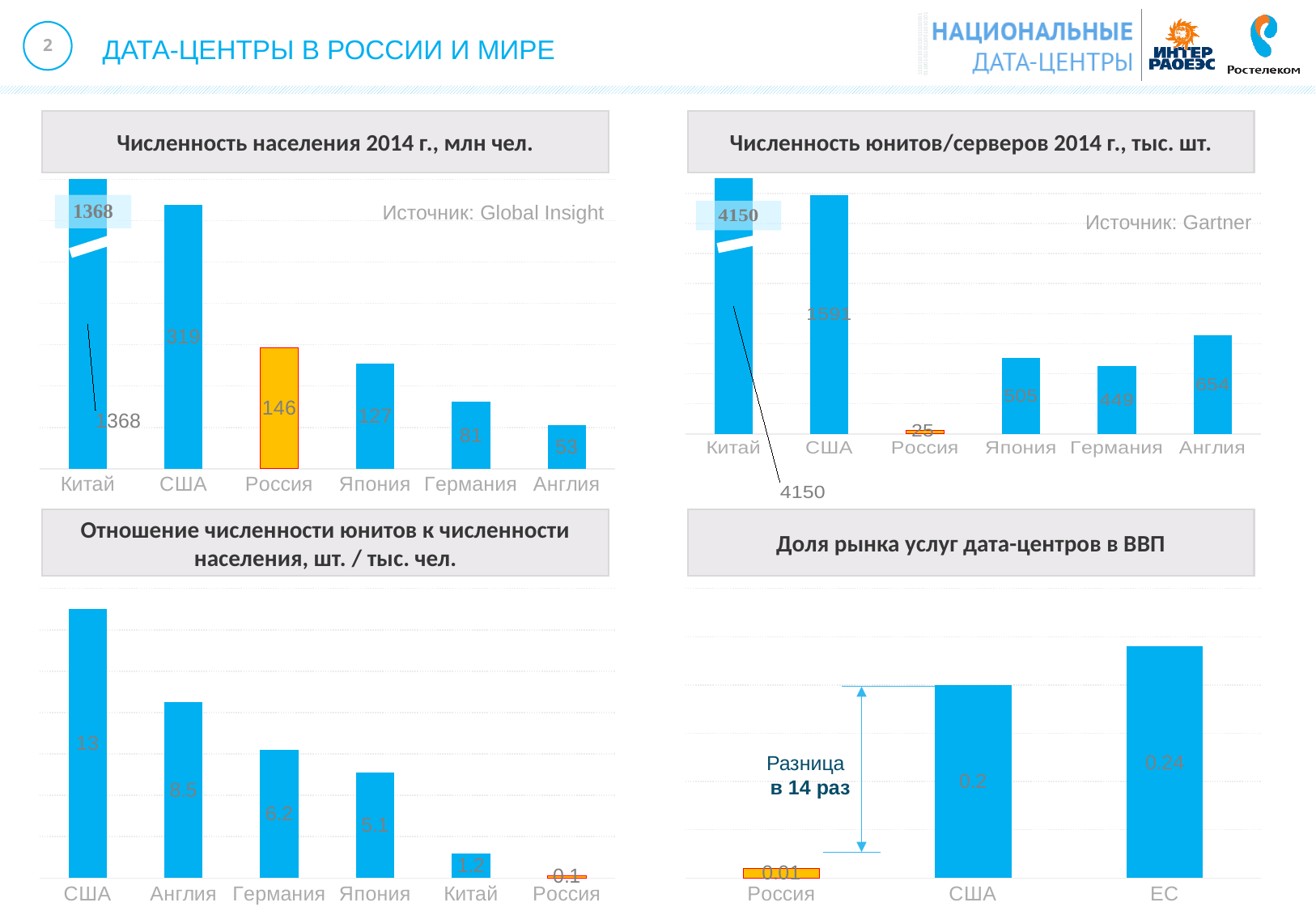
On the chart 'Отношение численности юнитов к численности населения, шт. / тыс. чел.', what is the value for Германия? 6.2 On the chart 'Доля рынка услуг дата-центров в ВВП', what is the difference between the values for США and Россия? 0.19 On the chart 'Численность юнитов/серверов 2014 г., тыс. шт.', how many countries are shown? 6 On the chart 'Доля рынка услуг дата-центров в ВВП', what is the value for ЕС? 0.24 On the chart 'Численность юнитов/серверов 2014 г., тыс. шт.', which is larger, the value for Англия or the value for Германия? Англия On the chart 'Численность населения 2014 г., млн чел.', which country has the lowest value? Англия On the chart 'Отношение численности юнитов к численности населения, шт. / тыс. чел.', which country has the highest value? США What kind of chart is 'Доля рынка услуг дата-центров в ВВП'? bar chart On the chart 'Численность населения 2014 г., млн чел.', what is the value for Россия? 146 On the chart 'Численность населения 2014 г., млн чел.', what is the difference between the values for США and Япония? 192 On the chart 'Численность юнитов/серверов 2014 г., тыс. шт.', what is the value for Китай? 4150 On the chart 'Отношение численности юнитов к численности населения, шт. / тыс. чел.', do the values rise or fall from left to right? fall